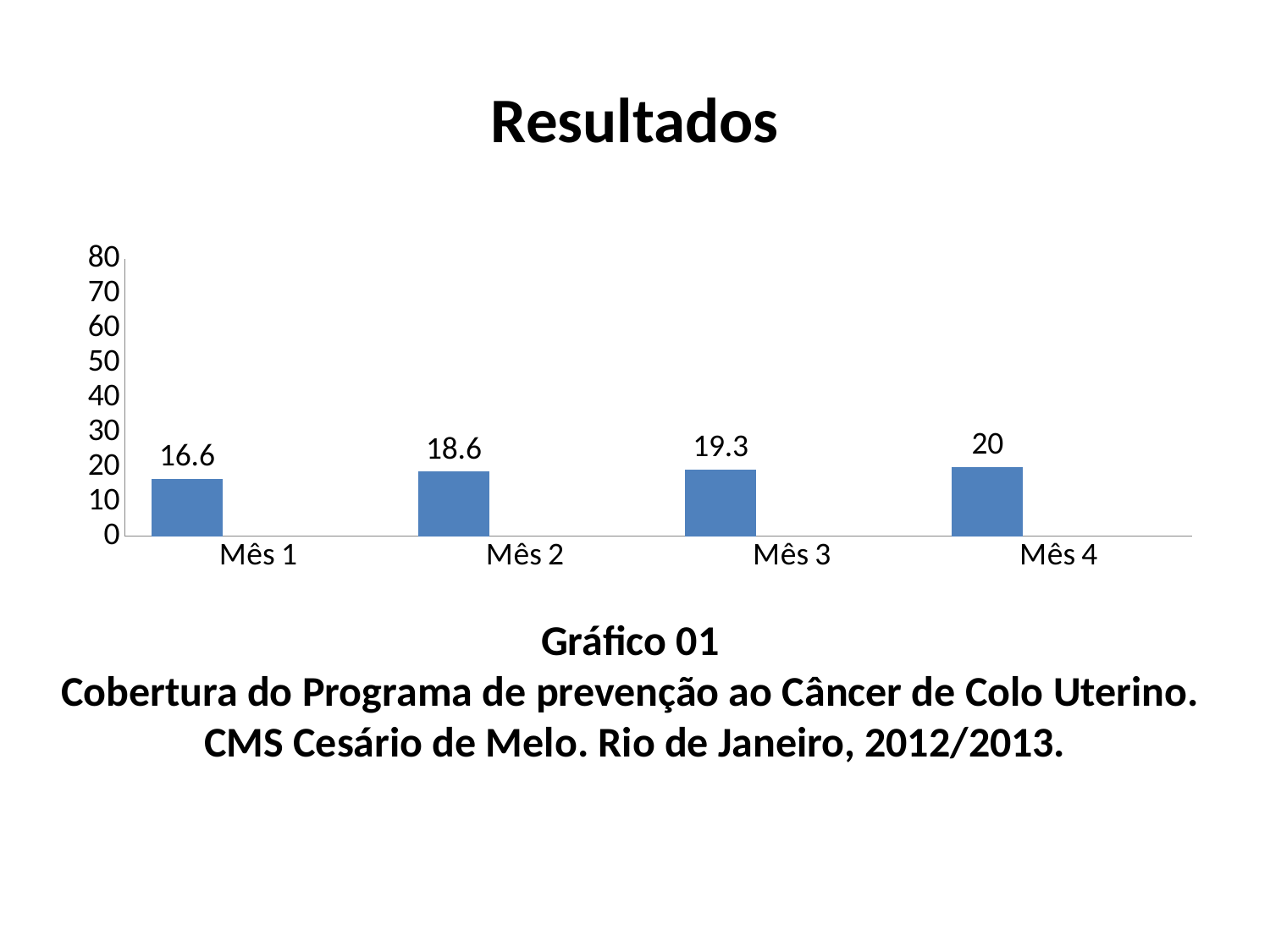
What is the value for Mês 4? 20 How many months are shown on the chart? 4 What is the difference between the values for Mês 4 and Mês 1? 3.4 What kind of chart is shown on the slide? bar chart What is the value for Mês 3? 19.3 Which month has the lowest value? Mês 1 Which is larger, the value for Mês 2 or the value for Mês 3? Mês 3 Which month has the highest value? Mês 4 What is the difference between the values for Mês 2 and Mês 1? 2 What is the value for Mês 1? 16.6 Do the values rise or fall from Mês 1 to Mês 4? rise Is the value for Mês 2 greater or less than 30? less